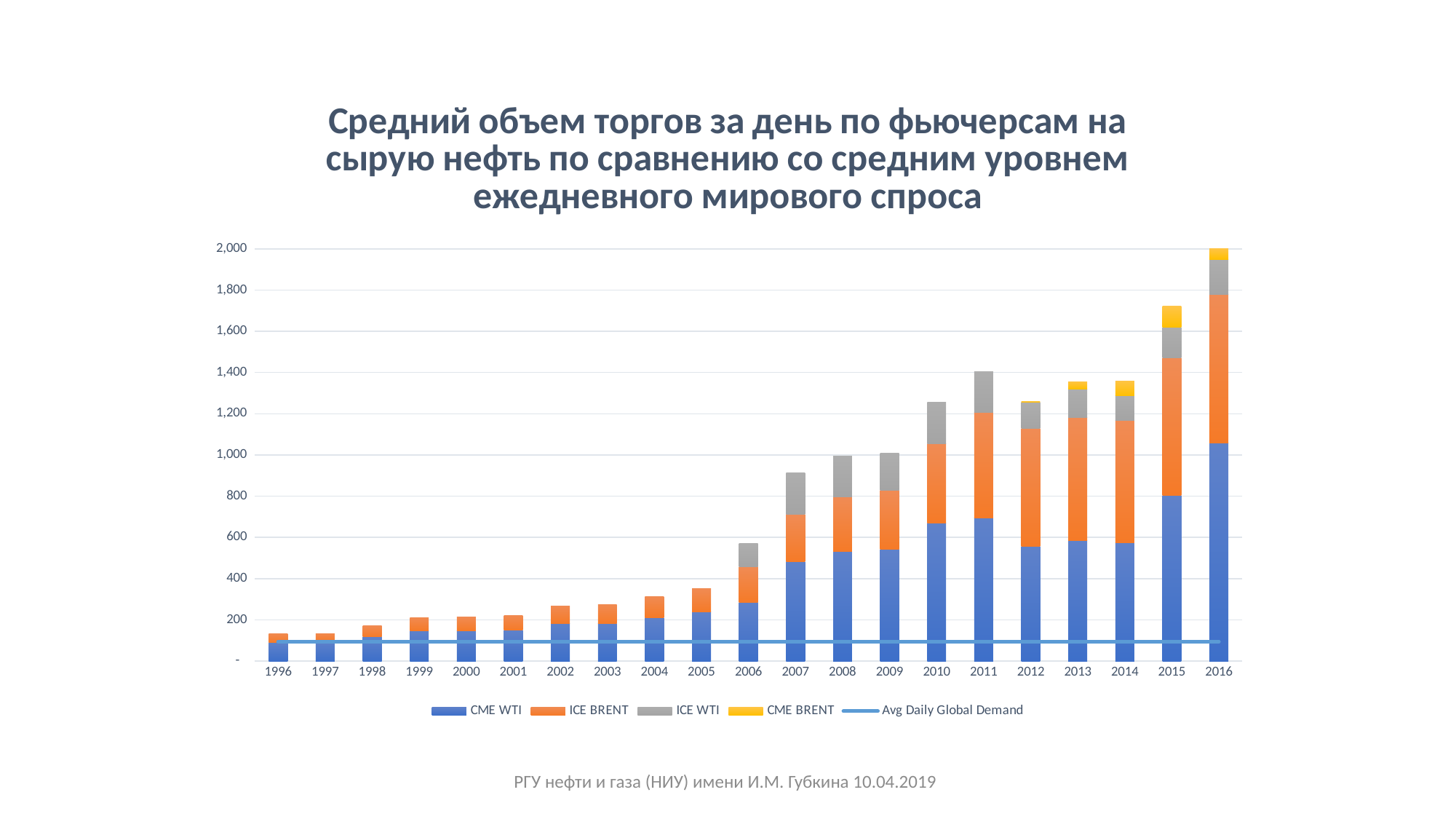
Do the total stacked bar values generally rise or fall from 1996 to 2016? rise Is the Avg Daily Global Demand line greater or less than 200? less Is the total stacked bar for 2016 greater or less than 1,800? greater Which year has the tallest stacked bar in the chart? 2016 Is the CME WTI value for 2016 greater or less than 1,000? greater Which year has the larger total stacked bar, 2011 or 2012? 2011 How many years are shown along the x axis of the chart? 21 Which series in the legend is shown in yellow? CME BRENT What kind of chart is shown on the slide? Stacked bar chart with a line How many series does the chart's legend list? 5